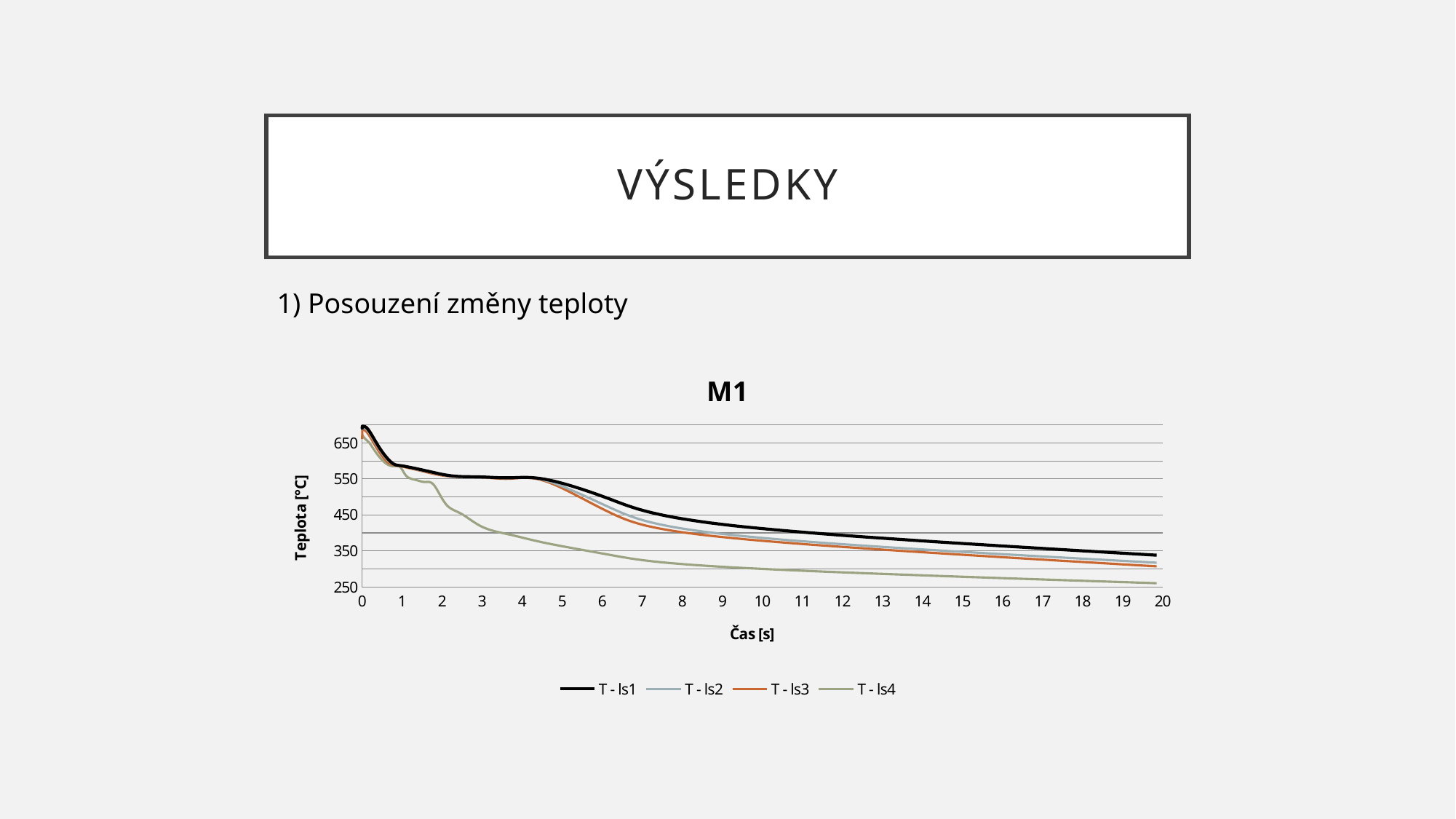
Is the value of T - ls4 at 20 s greater or less than 300? less Which series has the lowest temperature at 20 s? T - ls4 At 20 s, which series has the larger value, T - ls1 or T - ls4? T - ls1 What kind of chart is shown on the slide? line chart What is the title of the chart? M1 Do the temperature values rise or fall as time increases along the x axis? fall Is the value of T - ls1 at 0 s greater or less than 650? greater Is the value of T - ls1 at 10 s greater or less than 350? greater What is the label of the y axis of the chart? Teplota [°C] How many series does the chart's legend list? 4 Which series has the highest temperature at 20 s? T - ls1 How many tick labels are shown on the x axis of the chart? 21